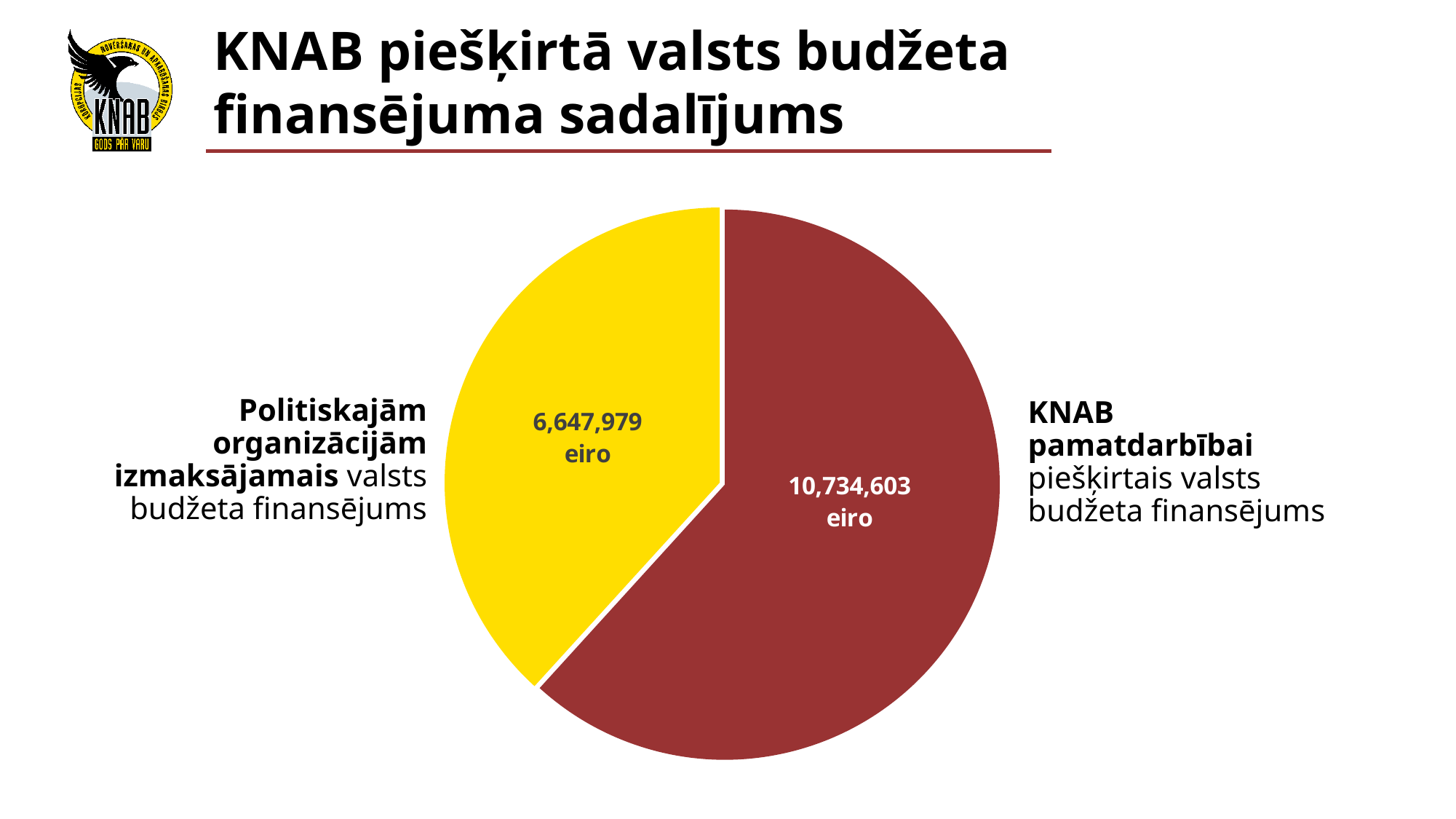
How many slices does the pie chart have? 2 What is the total of the two slices in the pie chart? 17,382,582 eiro What share of the pie does the KNAB pamatdarbībai slice represent, to the nearest whole percent? 62% Which is larger: the funding for KNAB pamatdarbībai or the funding for Politiskajām organizācijām? KNAB pamatdarbībai Which slice of the pie chart is the smallest? Politiskajām organizācijām izmaksājamais valsts budžeta finansējums Which slice of the pie chart is the largest? KNAB pamatdarbībai piešķirtais valsts budžeta finansējums What is the difference between the KNAB pamatdarbībai slice and the Politiskajām organizācijām slice? 4,086,624 eiro What is the value of the slice for KNAB pamatdarbībai piešķirtais valsts budžeta finansējums? 10,734,603 eiro What colour is the slice for Politiskajām organizācijām izmaksājamais valsts budžeta finansējums? yellow What is the value of the slice for Politiskajām organizācijām izmaksājamais valsts budžeta finansējums? 6,647,979 eiro What type of chart is shown on the slide? pie chart What is the title of the slide containing the pie chart? KNAB piešķirtā valsts budžeta finansējuma sadalījums